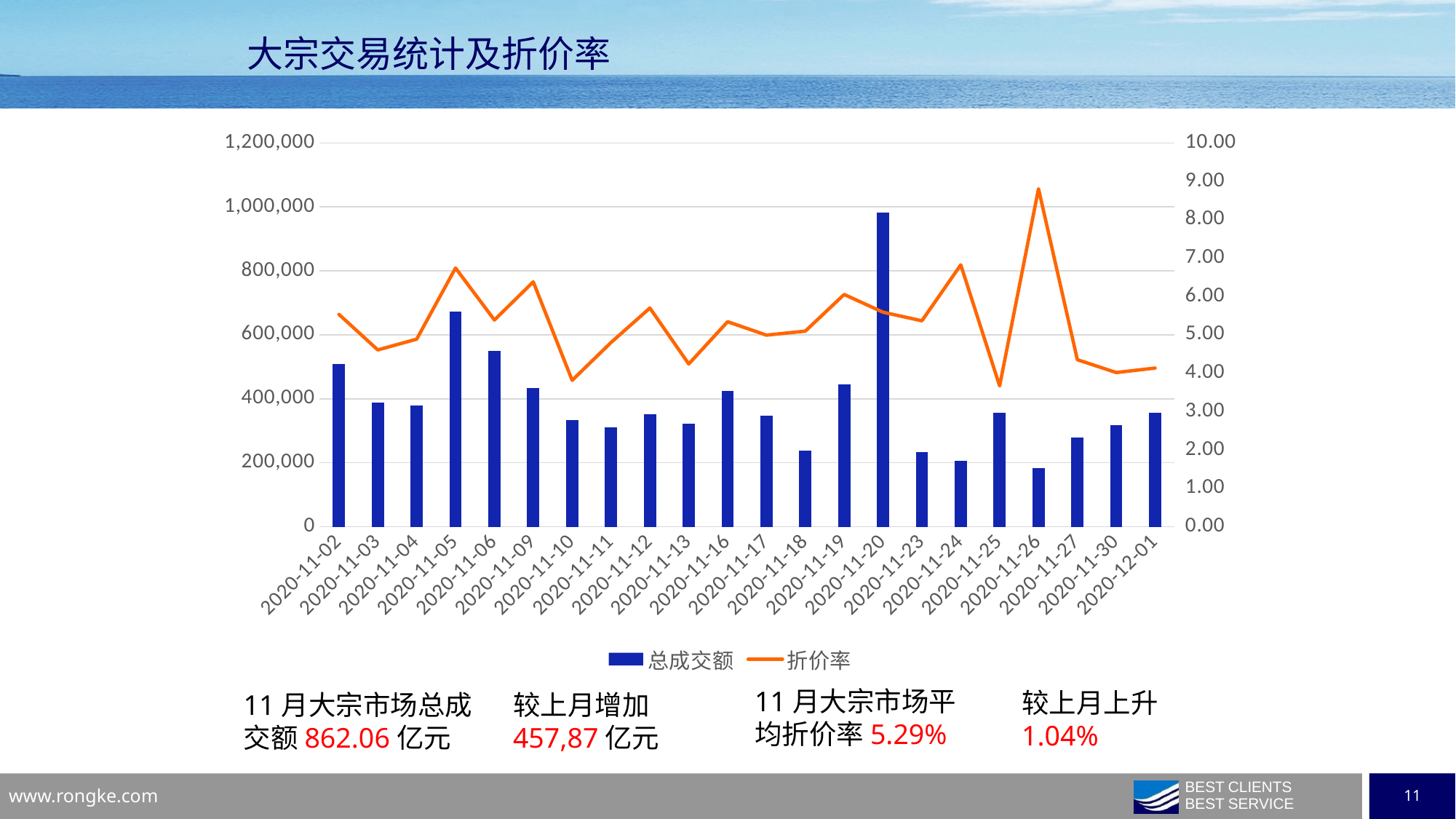
How many series does the legend list? 2 On which date does the 折价率 line reach its highest point? 2020-11-26 Which date has the larger 总成交额 bar, 2020-11-05 or 2020-11-06? 2020-11-05 On which date is the 总成交额 bar the lowest? 2020-11-26 Is the 总成交额 value for 2020-11-20 greater or less than 800,000? greater Is the 总成交额 value for 2020-11-26 greater or less than 200,000? less How many dates are shown on the x axis? 22 Which date has the larger 总成交额 bar, 2020-11-02 or 2020-11-03? 2020-11-02 What are the two series named in the legend? 总成交额 and 折价率 On which date is the 总成交额 bar the highest? 2020-11-20 Is the 折价率 value for 2020-11-26 greater or less than 8.00? greater What kind of chart is shown on the slide? A combined bar and line chart